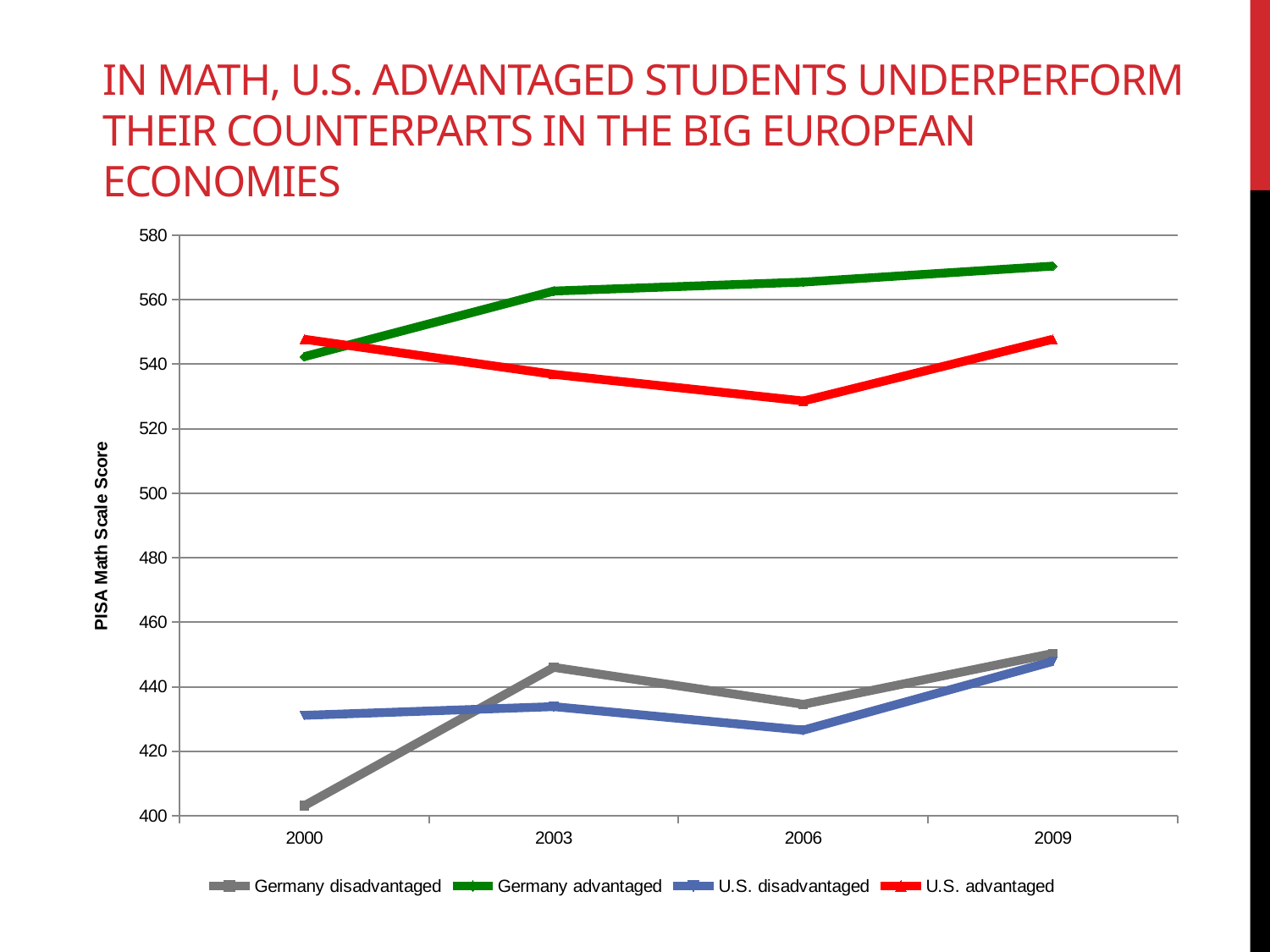
Which series has the highest value in 2009? Germany advantaged What kind of chart is shown on the slide? line chart What is the label on the y axis? PISA Math Scale Score Is the value for Germany advantaged in 2009 greater or less than 560? greater Is the value for U.S. advantaged in 2006 greater or less than 540? less In 2006, which is larger: the value for Germany advantaged or the value for U.S. advantaged? Germany advantaged Is the value for U.S. disadvantaged in 2009 greater or less than 440? greater How many series does the legend list? 4 Does the Germany advantaged series rise or fall from 2000 to 2009? rise Which series has the lowest value in 2000? Germany disadvantaged How many years are plotted along the x axis? 4